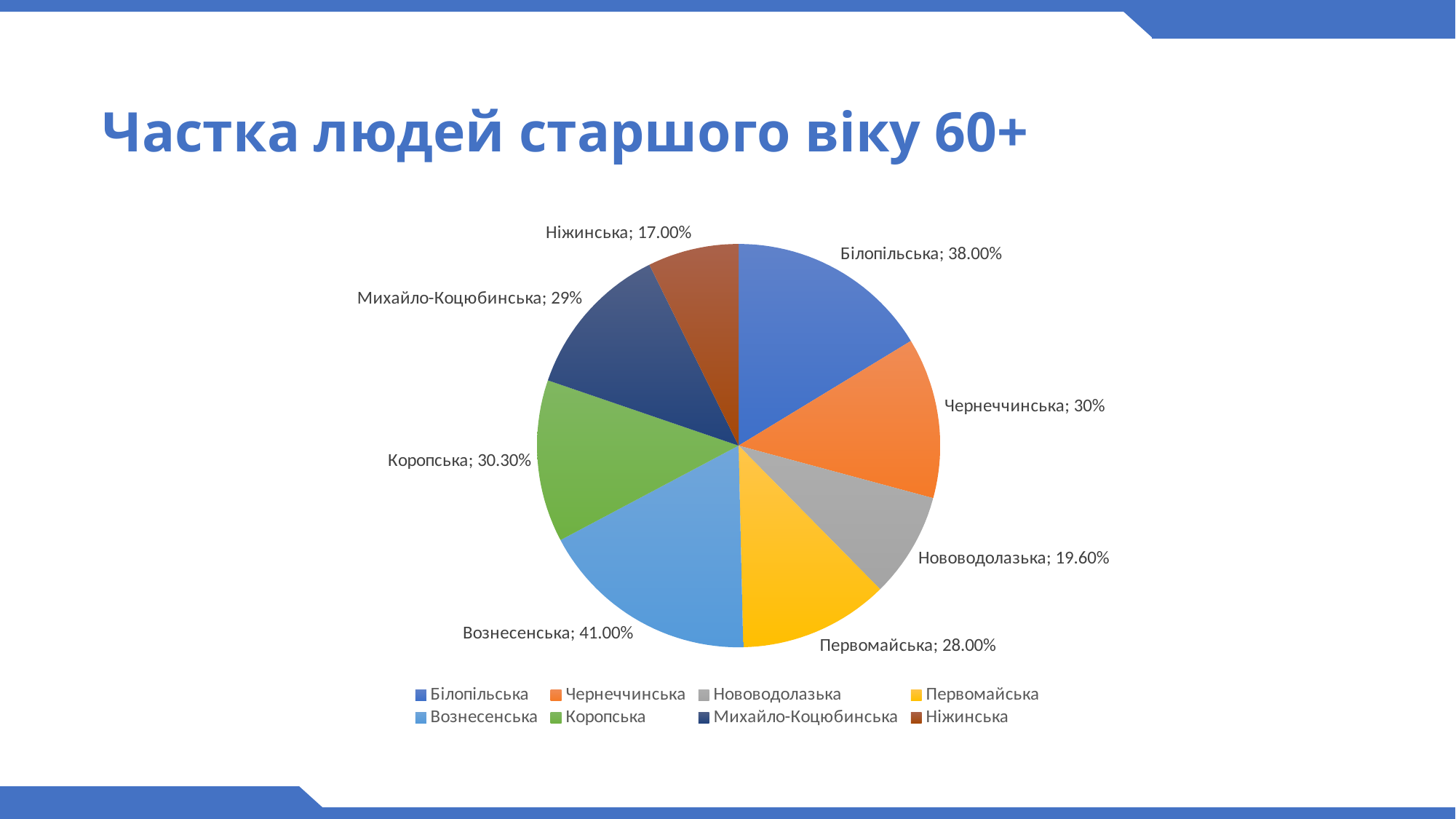
Which category has the lowest value in the pie chart? Ніжинська What kind of chart is shown on the slide? pie chart What is the difference between the values for Вознесенська and Білопільська? 3.00% Which category has the highest value in the pie chart? Вознесенська What is the value shown for Михайло-Коцюбинська? 29% Which has a larger value, Білопільська or Первомайська? Білопільська What is the difference between the values for Первомайська and Ніжинська? 11.00% What is the value shown for Нововодолазька? 19.60% What is the title of the slide above the chart? Частка людей старшого віку 60+ What is the value shown for Вознесенська? 41.00% How many categories (slices) does the pie chart have? 8 What is the value shown for Коропська? 30.30%